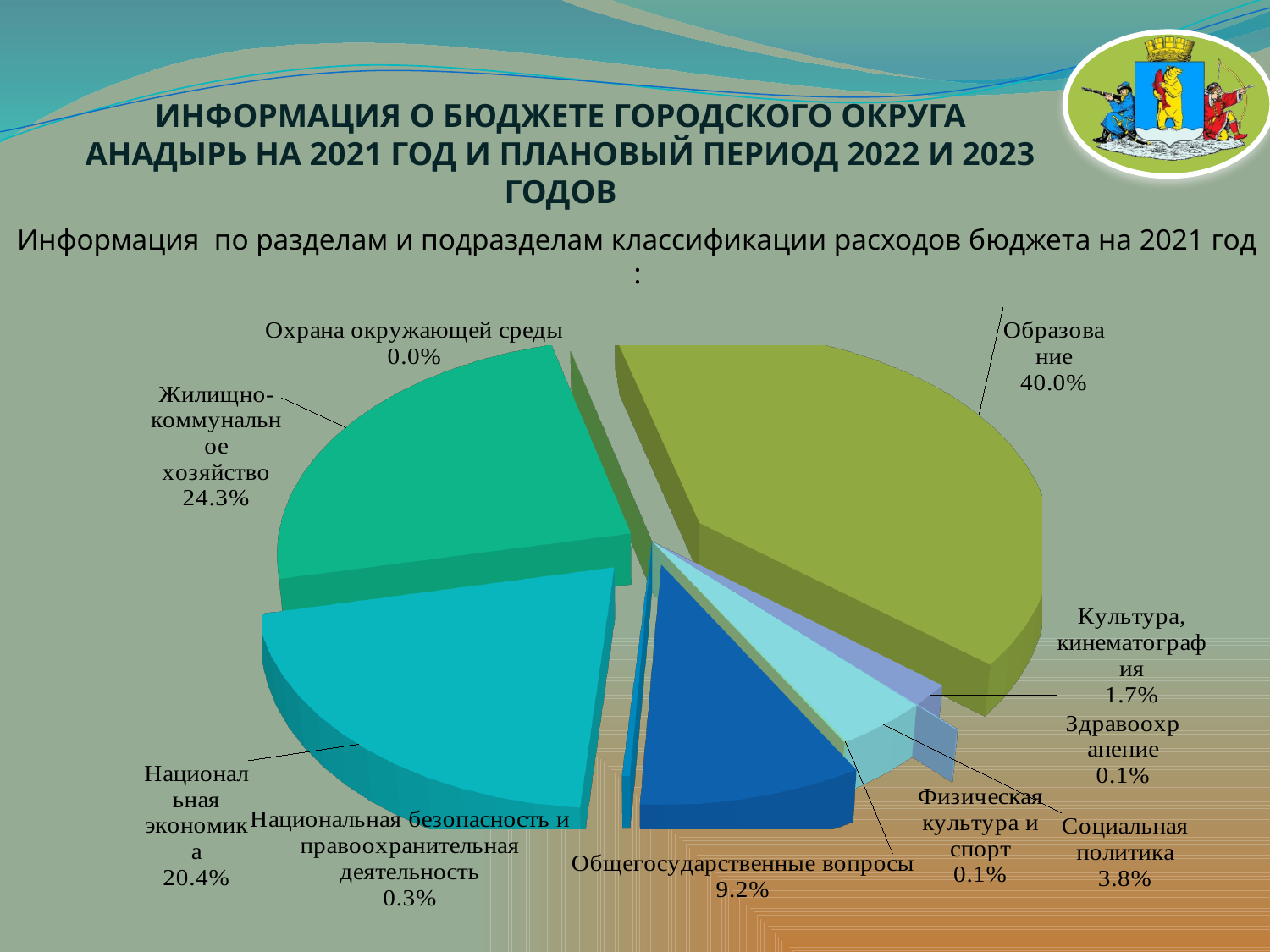
Which category has the largest share of the pie? Образование What is the value shown for Национальная экономика? 20.4% What kind of chart is shown on the slide? pie chart What is the value shown for Общегосударственные вопросы? 9.2% What is the value shown for Социальная политика? 3.8% What is the difference between the shares of Образование and Жилищно-коммунальное хозяйство? 15.7% What is the value shown for Культура, кинематография? 1.7% Which category has the smallest share of the pie? Охрана окружающей среды What share of the pie does Образование have? 40.0% What is the value shown for Жилищно-коммунальное хозяйство? 24.3% Which is larger, the share of Национальная экономика or the share of Общегосударственные вопросы? Национальная экономика How many categories are shown in the pie chart? 10